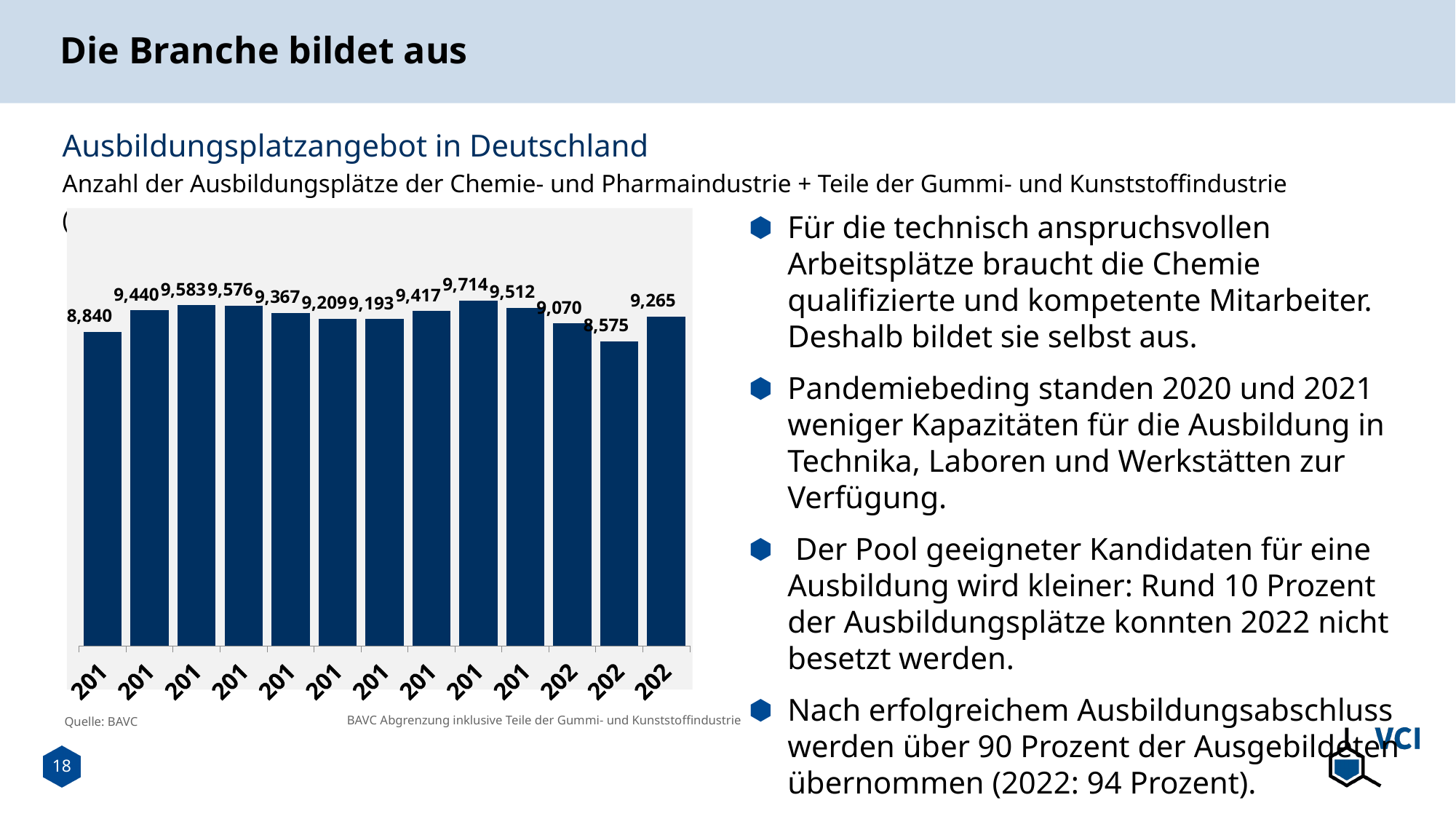
How many bars does the chart contain? 13 Does the value rise or fall from the first bar to the second bar? rise What is the highest value shown in the chart? 9,714 What kind of chart is shown on the slide? bar chart What is the title of the chart? Ausbildungsplatzangebot in Deutschland Which is larger, the first bar or the last bar? the last bar What is the value of the first (leftmost) bar in the chart? 8,840 What is the value of the last (rightmost) bar in the chart? 9,265 By how much does the last bar exceed the second-to-last bar? 690 What is the lowest value shown in the chart? 8,575 What is the difference between the highest and the lowest value in the chart? 1,139 What is the value of the third bar from the left? 9,583